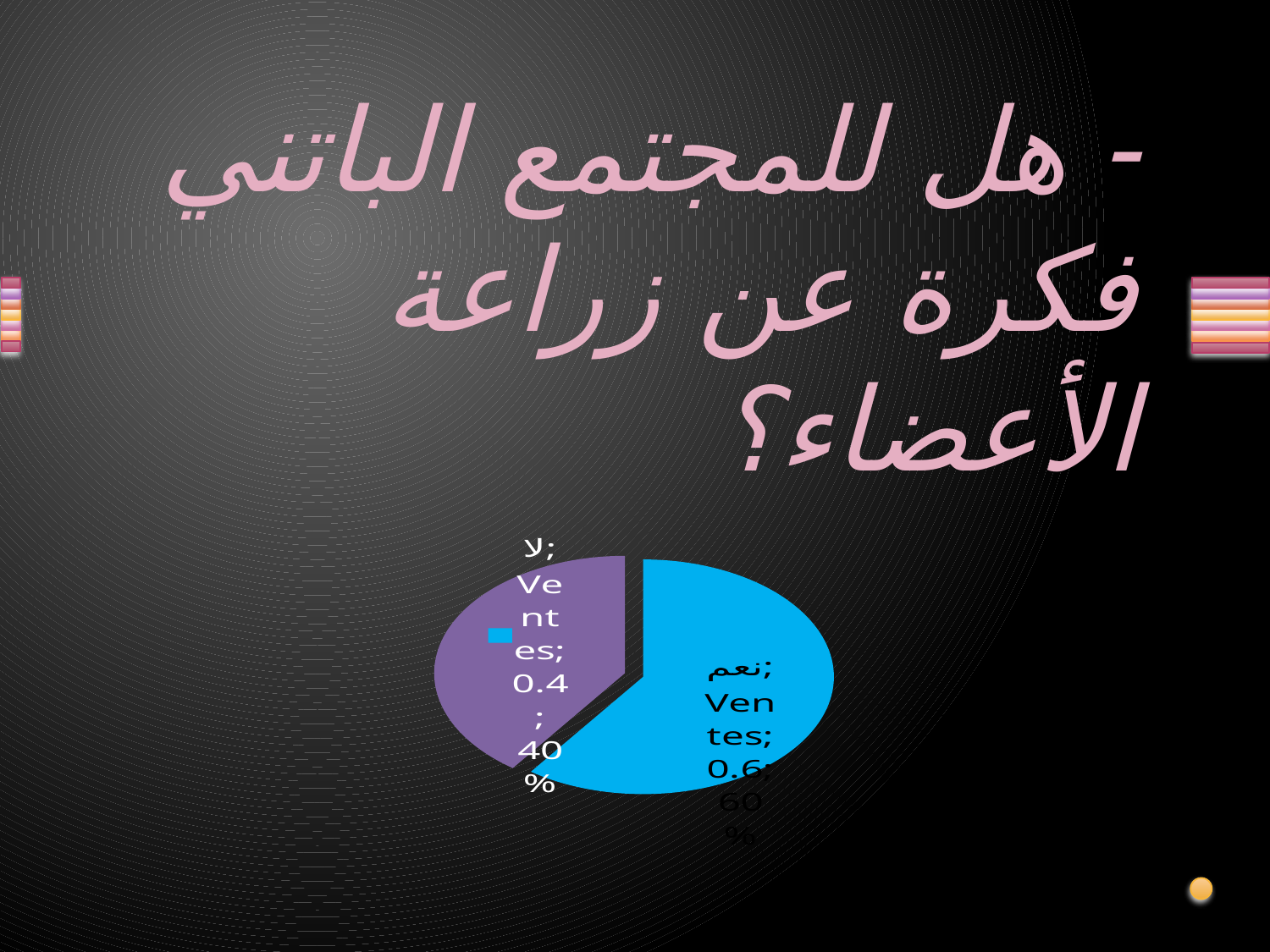
What is the difference in percentage points between the نعم slice and the لا slice? 20% What value is printed on the data label for the لا slice? 0.4 What percentage of the pie does the لا slice represent? 40% How many slices does the pie chart have? 2 What value is printed on the data label for the نعم slice? 0.6 What kind of chart is shown on the slide? pie chart What series name appears in the data labels of the pie chart? Ventes Which slice is the smallest in the pie chart? لا What percentage of the pie does the نعم slice represent? 60% What colour is the نعم slice of the pie chart? blue Which slice is larger, نعم or لا? نعم Which slice is the largest in the pie chart? نعم